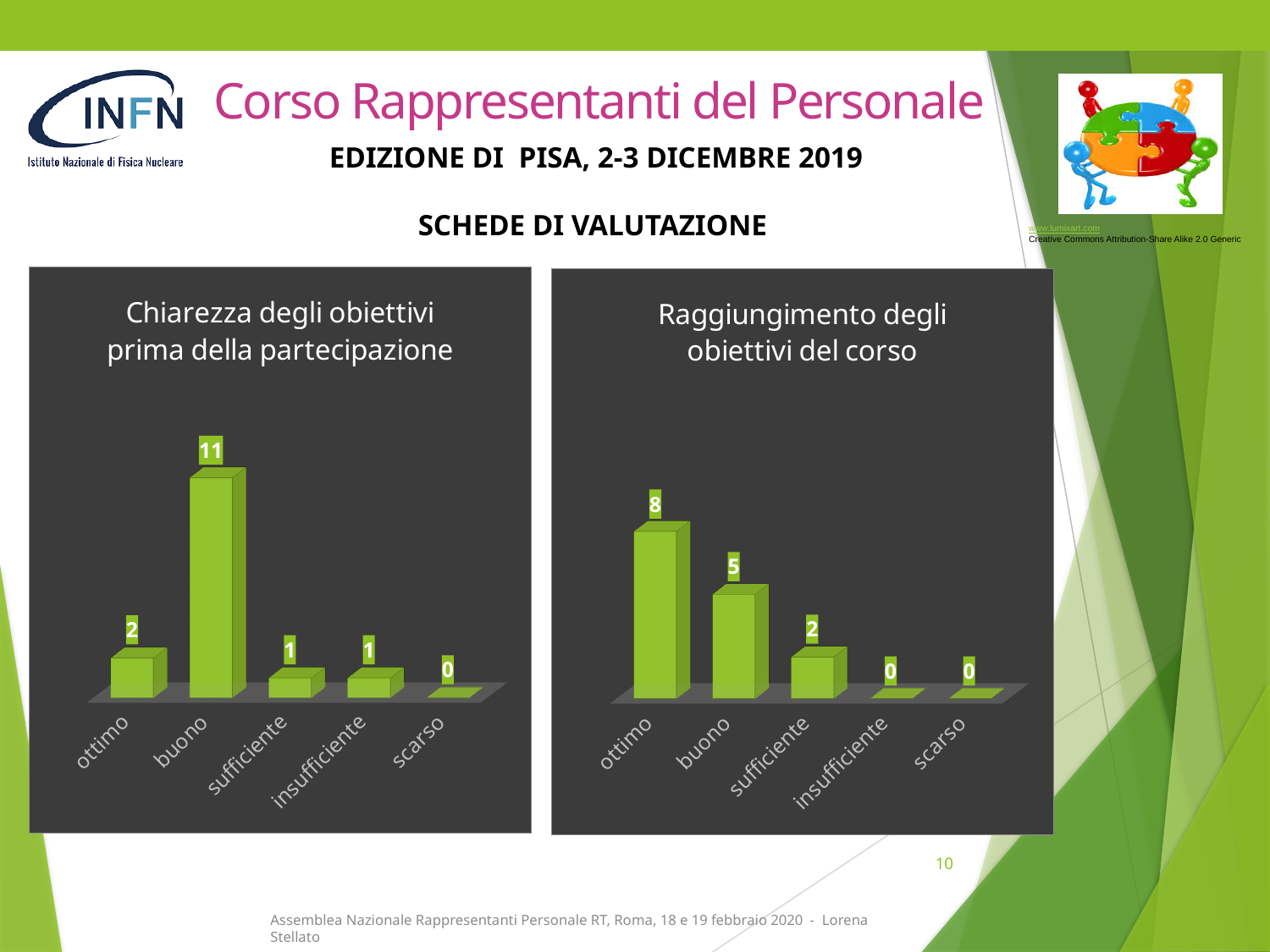
In the chart 'Raggiungimento degli obiettivi del corso', what is the difference between the values for 'ottimo' and 'buono'? 3 In the chart 'Raggiungimento degli obiettivi del corso', which category has the highest value? ottimo In the chart 'Raggiungimento degli obiettivi del corso', do the values rise or fall from 'ottimo' to 'scarso'? fall In the chart 'Raggiungimento degli obiettivi del corso', what is the value for 'ottimo'? 8 In the chart 'Chiarezza degli obiettivi prima della partecipazione', what is the difference between the values for 'buono' and 'ottimo'? 9 In the chart 'Chiarezza degli obiettivi prima della partecipazione', which category has the highest value? buono In the chart 'Chiarezza degli obiettivi prima della partecipazione', what is the value for 'ottimo'? 2 What kind of chart is 'Raggiungimento degli obiettivi del corso'? bar chart In the chart 'Raggiungimento degli obiettivi del corso', which is larger, the value for 'buono' or the value for 'sufficiente'? buono How many categories are shown in the chart 'Chiarezza degli obiettivi prima della partecipazione'? 5 In the chart 'Raggiungimento degli obiettivi del corso', what is the value for 'sufficiente'? 2 In the chart 'Chiarezza degli obiettivi prima della partecipazione', what is the value for 'buono'? 11